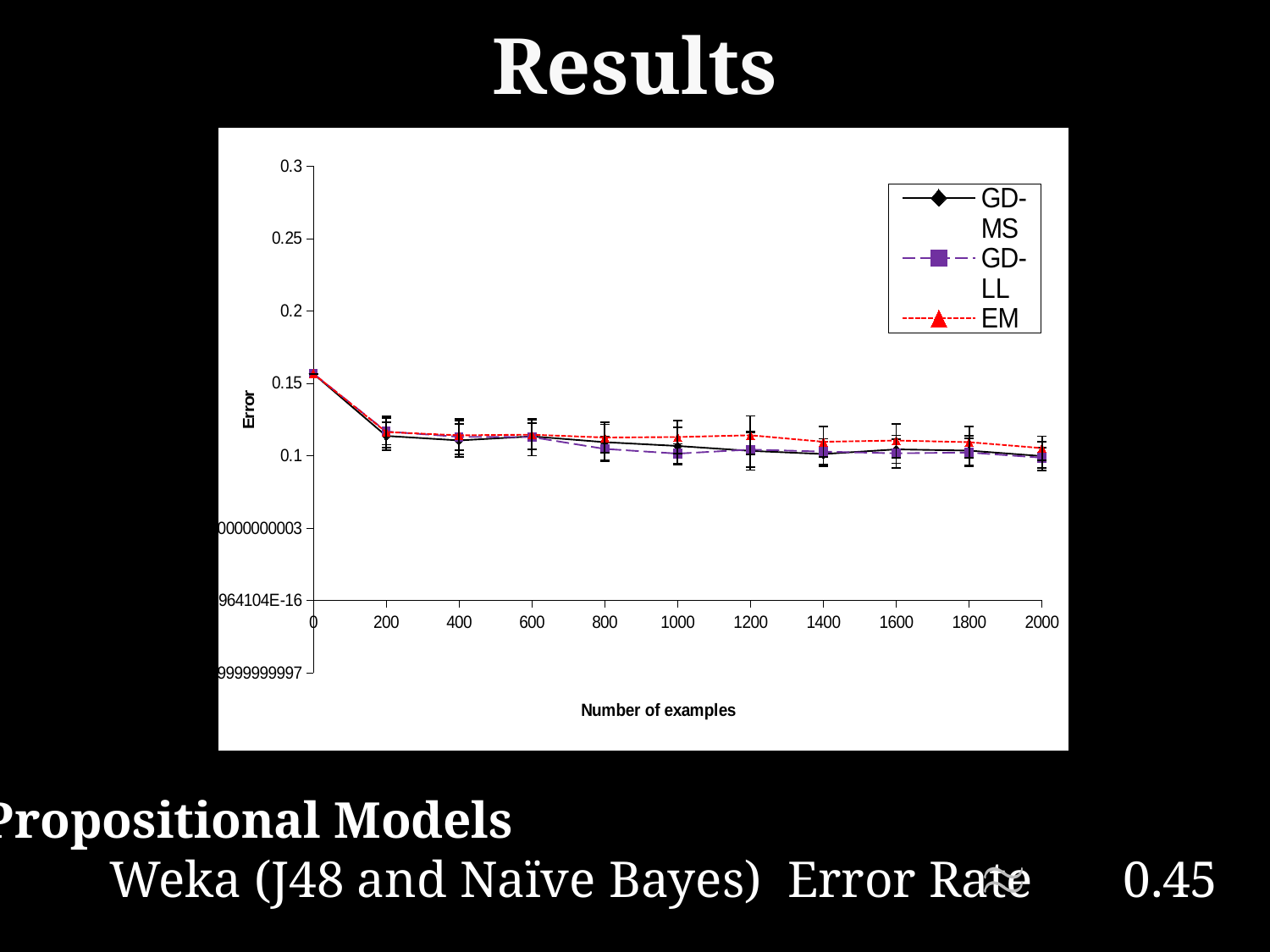
What is the title of the x axis? Number of examples What are the names of the series in the legend? GD-MS, GD-LL, EM Is the error for GD-LL at 400 examples greater or less than 0.2? less Is the error for EM at 1200 examples greater or less than 0.1? greater How many series does the legend list? 3 Does the error rise or fall as the number of examples increases? fall Is the error for EM at 200 examples greater or less than 0.15? less How many data points are plotted for each series along the x axis? 11 Which series has the highest error at 1200 examples? EM What kind of chart is shown on the slide? line chart At 1200 examples, which series has the higher error, EM or GD-LL? EM